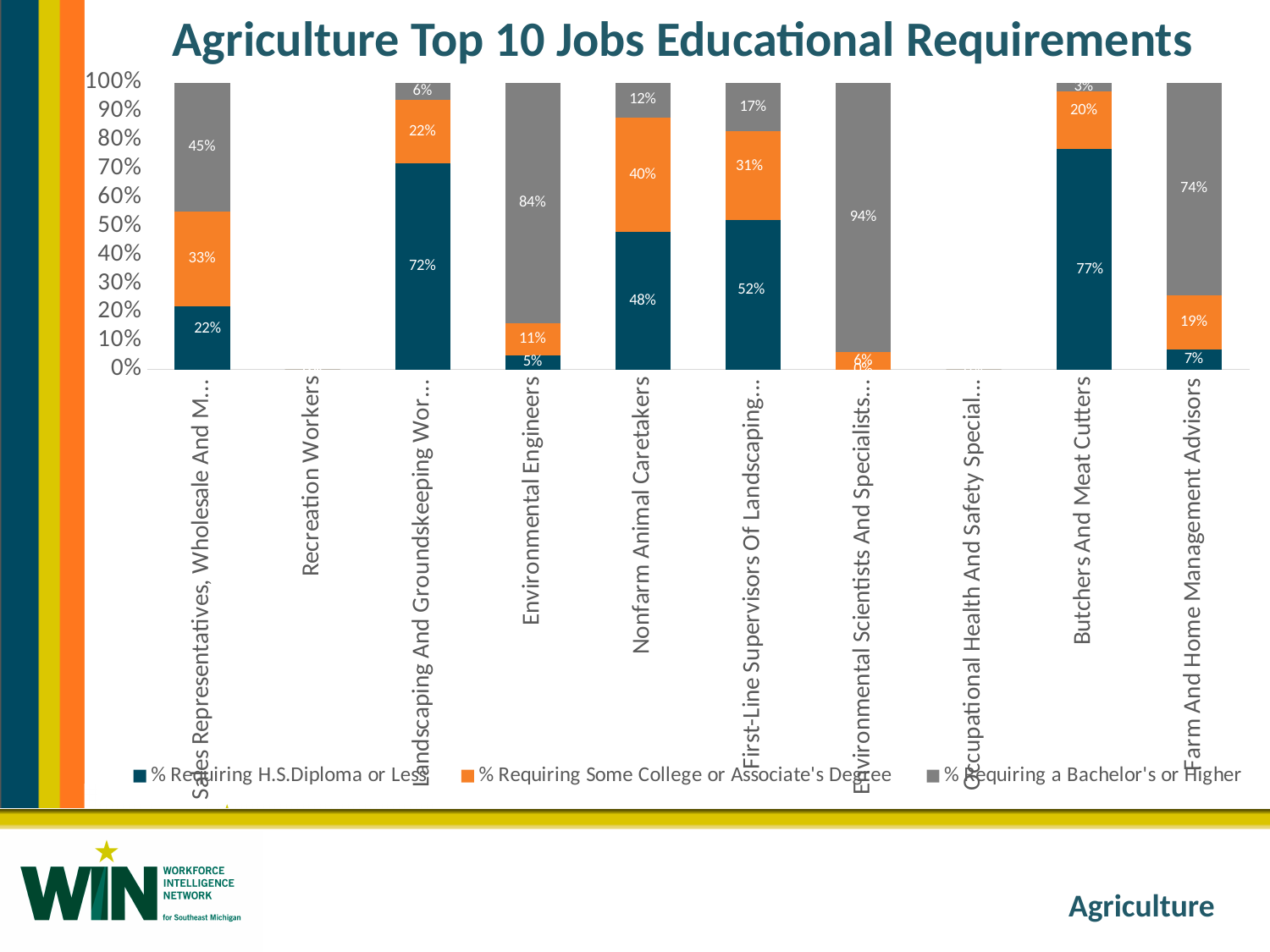
How many series does the legend list? 3 Which has a larger % Requiring Some College or Associate's Degree: Nonfarm Animal Caretakers or Farm And Home Management Advisors? Nonfarm Animal Caretakers What is the % Requiring H.S. Diploma or Less for Butchers And Meat Cutters? 77% What is the % Requiring Some College or Associate's Degree for Nonfarm Animal Caretakers? 40% How many job categories are shown on the x axis? 10 What type of chart is shown on the slide? Stacked bar chart Among the jobs with plotted bars, which has the lowest % Requiring a Bachelor's or Higher? Butchers And Meat Cutters What is the difference in % Requiring a Bachelor's or Higher between Environmental Engineers and Farm And Home Management Advisors? 10 percentage points What colour represents % Requiring a Bachelor's or Higher in the legend? Gray What is the % Requiring H.S. Diploma or Less for Farm And Home Management Advisors? 7% Which job has the highest % Requiring H.S. Diploma or Less? Butchers And Meat Cutters What is the % Requiring a Bachelor's or Higher for Environmental Engineers? 84%